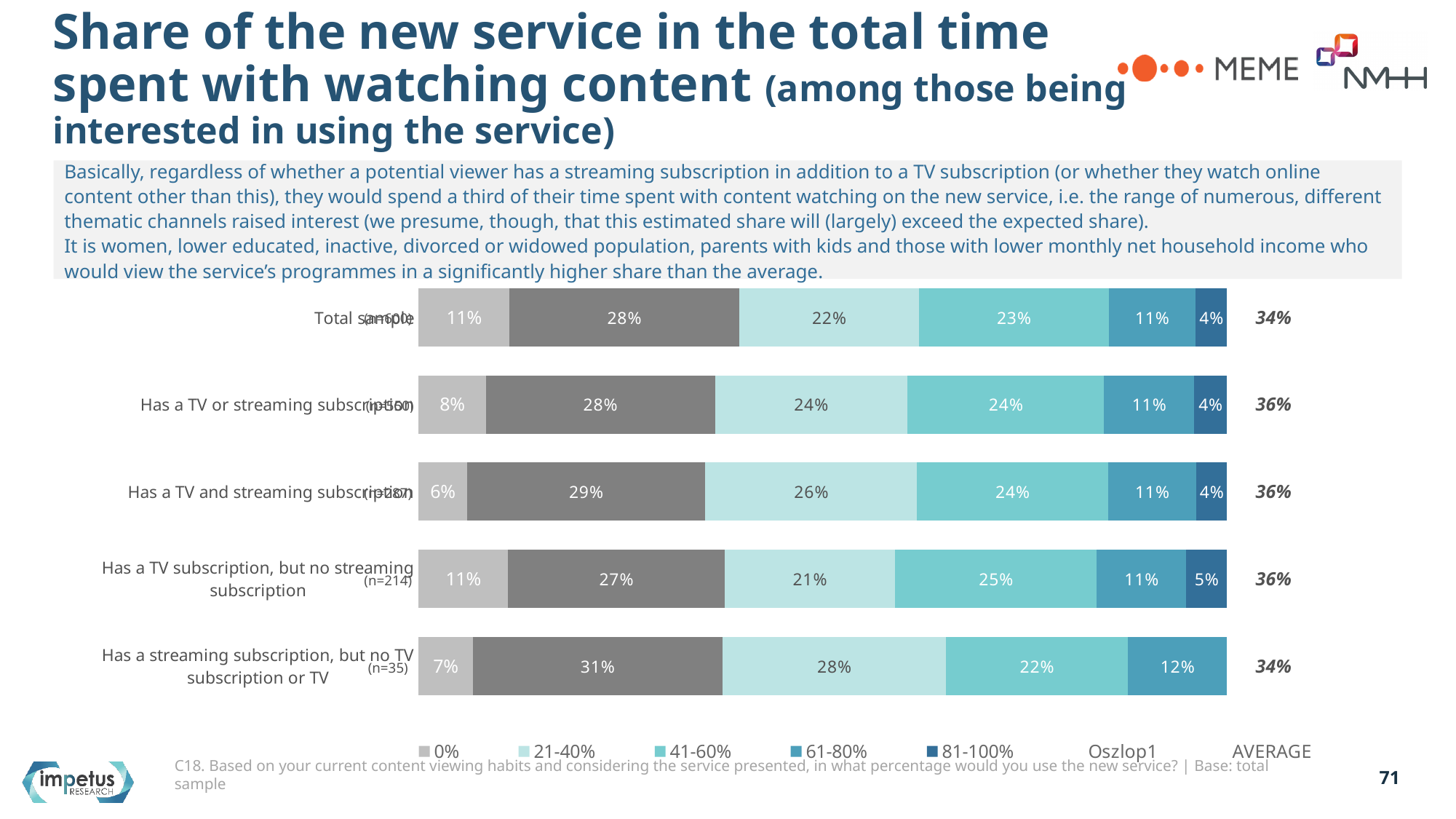
What is the AVERAGE value shown for 'Has a TV or streaming subscription'? 36% Which group has the largest 21-40% segment? Has a streaming subscription, but no TV subscription or TV Which has a larger 41-60% segment: the Total sample or 'Has a TV subscription, but no streaming subscription'? Has a TV subscription, but no streaming subscription Which group has the smallest 0% segment? Has a TV and streaming subscription How many respondent groups (bars) are shown in the chart? 5 What is the 61-80% segment value for 'Has a streaming subscription, but no TV subscription or TV'? 12% What is the 81-100% segment value for 'Has a TV subscription, but no streaming subscription'? 5% What is the 0% segment value for 'Has a TV and streaming subscription'? 6% What is the 21-40% segment value for 'Has a streaming subscription, but no TV subscription or TV'? 28% What kind of chart is shown on the slide? Stacked bar chart What is the AVERAGE value shown for the Total sample? 34% What is the difference between the 21-40% segment of 'Has a TV and streaming subscription' and that of the Total sample? 4 percentage points